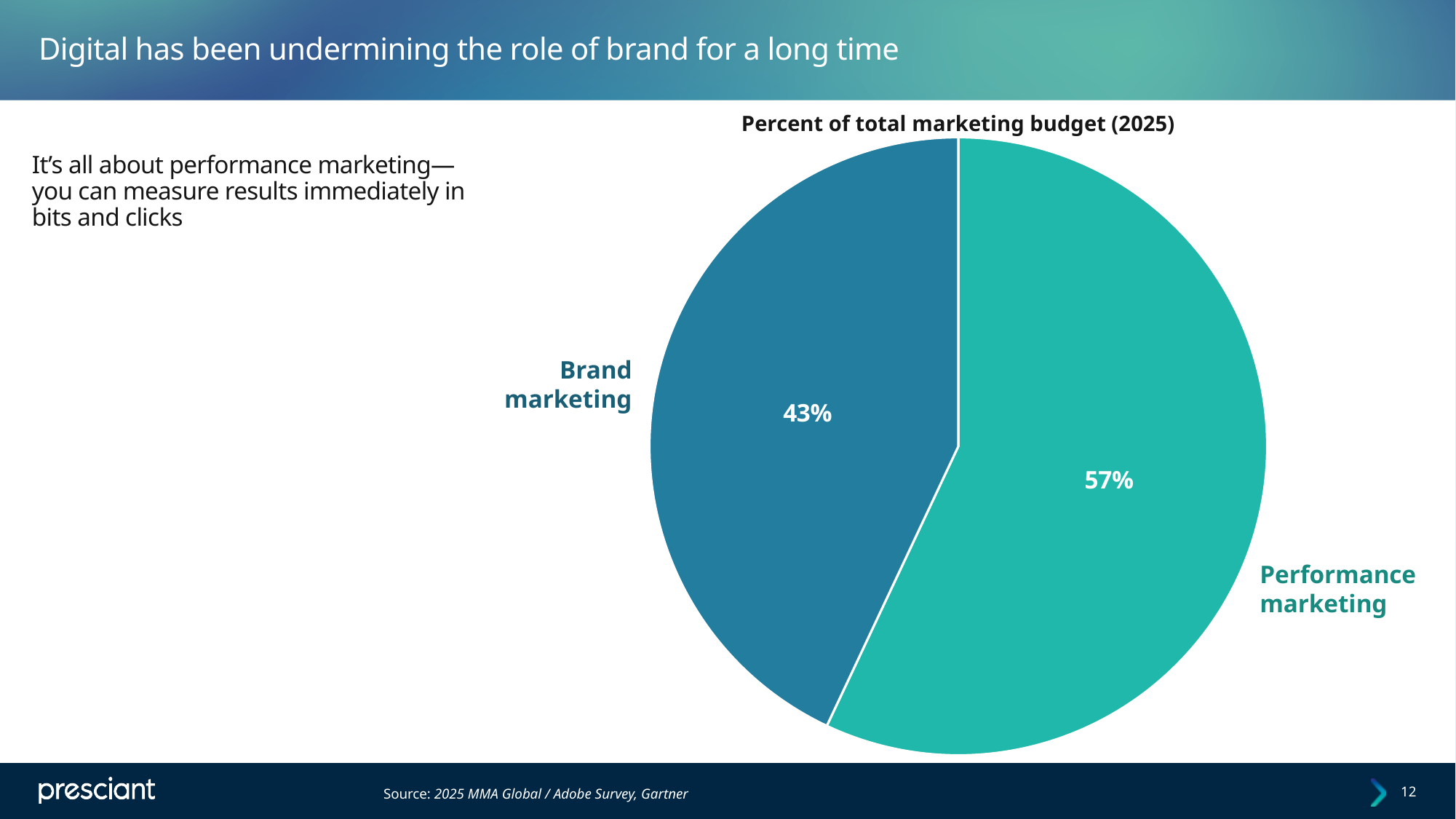
Which slice of the pie is the largest? Performance marketing Which slice is coloured dark blue? Brand marketing Which slice of the pie is the smallest? Brand marketing What share of the pie does the Brand marketing slice represent? 43% What is the difference in percentage points between Performance marketing and Brand marketing? 14 How many slices does the pie chart have? 2 What percentage of the total marketing budget goes to Performance marketing? 57% What percentage of the total marketing budget goes to Brand marketing? 43% Which is larger, the share for Brand marketing or the share for Performance marketing? Performance marketing What is the title of the chart? Percent of total marketing budget (2025) What kind of chart is shown on the slide? Pie chart